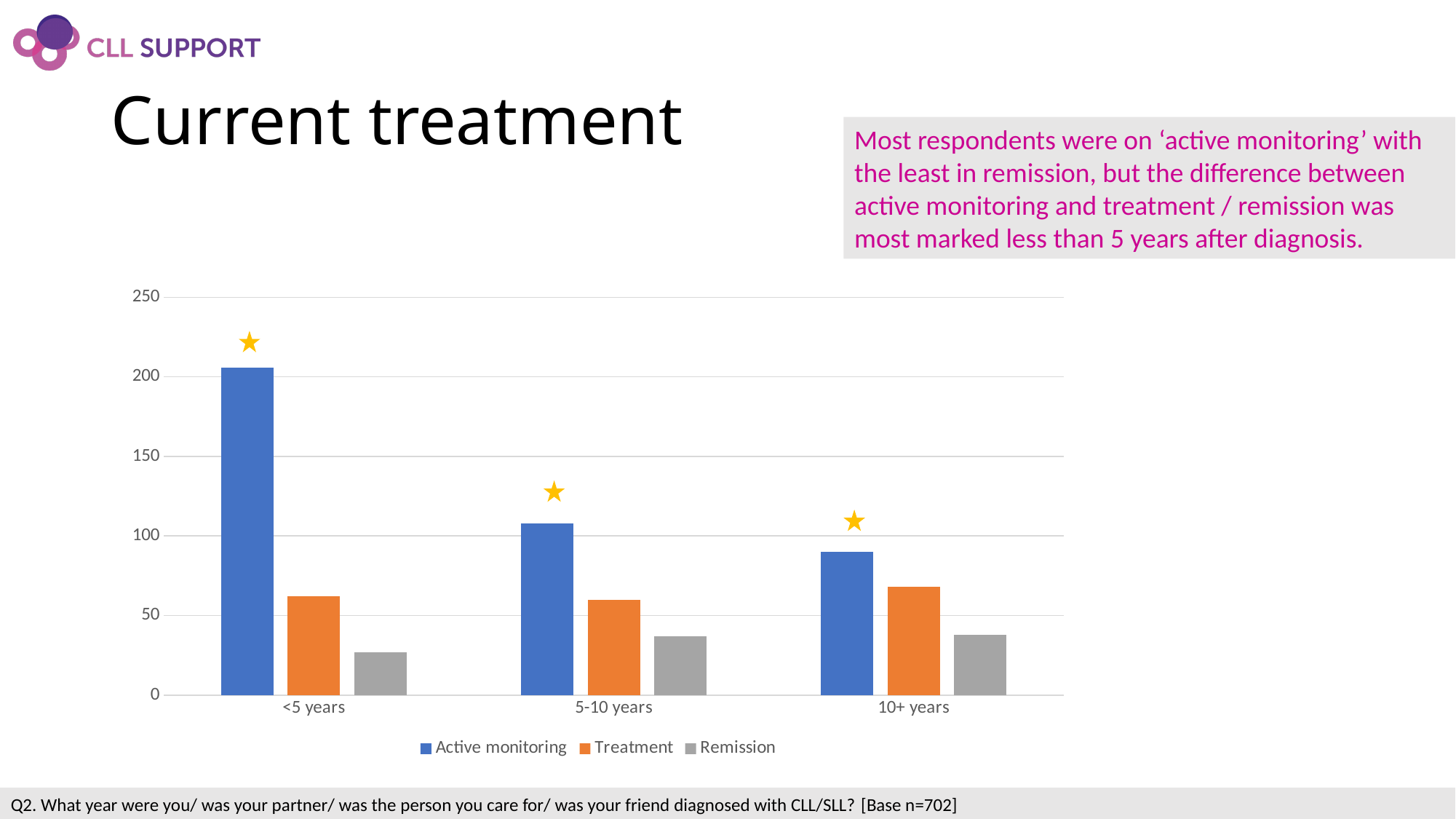
How many categories are shown on the x axis? 3 In which category is the Active monitoring bar highest? <5 years How many series does the legend list? 3 Is the value for Active monitoring in the <5 years category greater or less than 150? greater Do the Active monitoring values rise or fall from <5 years to 10+ years? fall Is the value for Active monitoring in the 10+ years category greater or less than 100? less Which series has the tallest bar in the <5 years category? Active monitoring Which series has the shortest bar in the 10+ years category? Remission Is the value for Remission in the <5 years category greater or less than 50? less In which category is the Remission bar lowest? <5 years Which is larger: Active monitoring in the <5 years category or Active monitoring in the 5-10 years category? <5 years What kind of chart is shown on the slide? bar chart